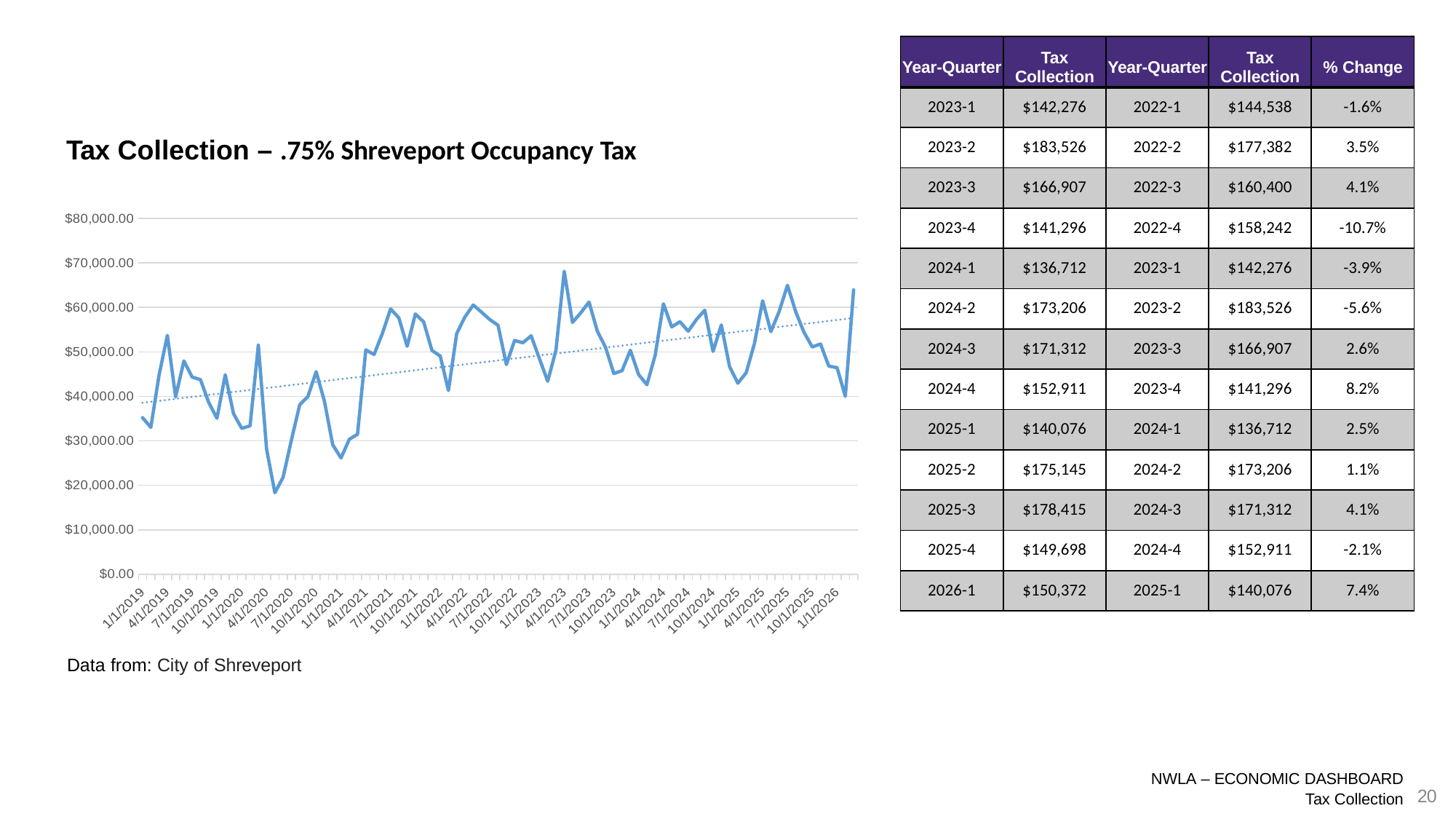
Is the highest point on the line, around early 2023, greater or less than $60,000.00? greater Overall, do the plotted values rise or fall across the period from 2019 to 2026? rise What is the title of the chart? Tax Collection – .75% Shreveport Occupancy Tax What is the highest value shown on the chart's vertical axis? $80,000.00 What kind of chart is shown on the slide? line chart Is the first plotted value, at 1/1/2019, greater or less than $40,000.00? less Is the last plotted value, at the start of 2026, greater or less than $60,000.00? greater Does the dotted trend line on the chart rise or fall from left to right? rise